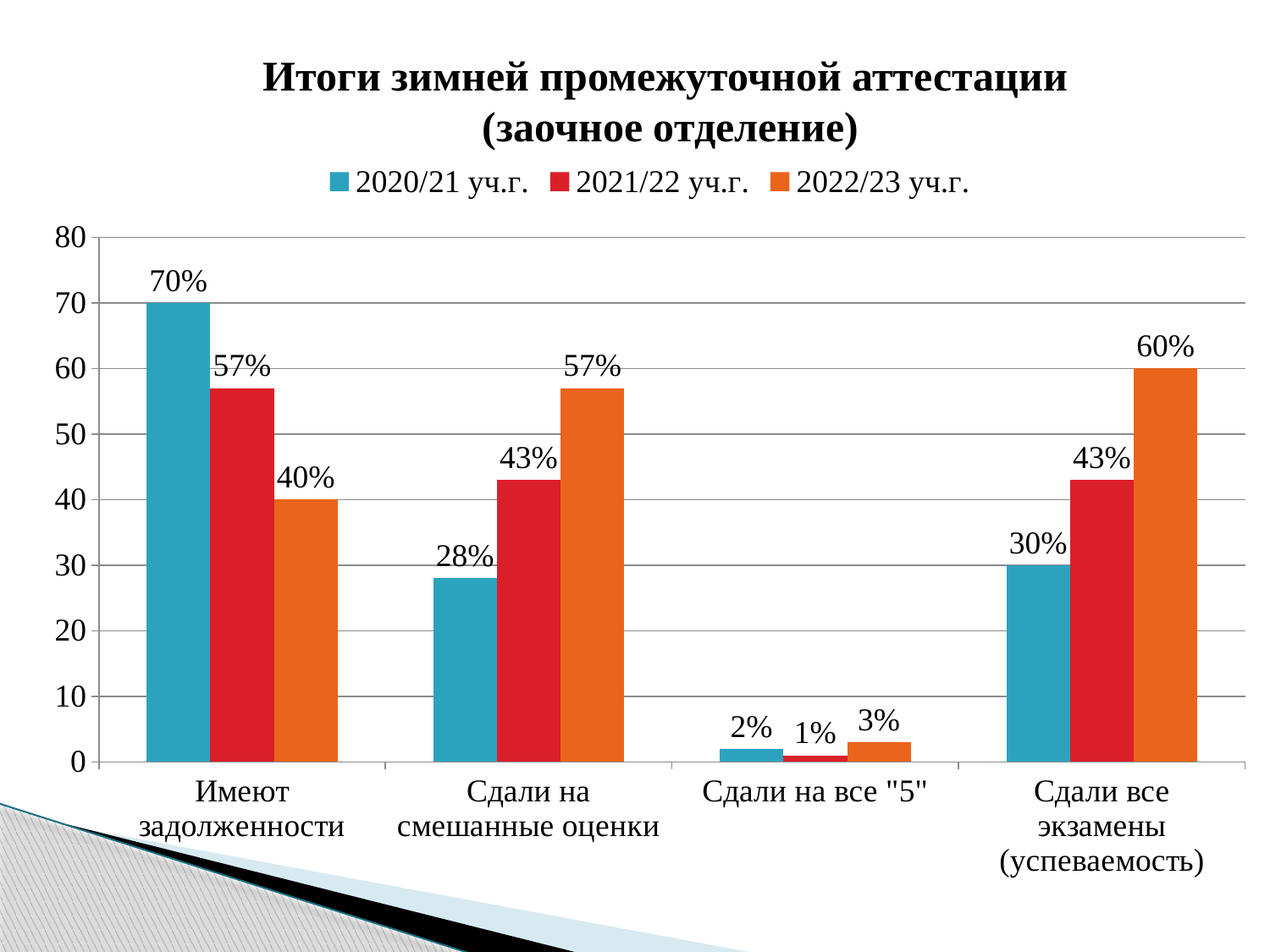
How many categories are shown on the x axis? 4 Which is larger in the "Сдали на смешанные оценки" category: the value for 2021/22 уч.г. or for 2022/23 уч.г.? 2022/23 уч.г. How many series does the legend list? 3 What is the difference between the 2020/21 уч.г. and 2022/23 уч.г. values in the "Имеют задолженности" category? 30% What is the value for 2022/23 уч.г. in the "Сдали все экзамены (успеваемость)" category? 60% Do the values for the "Имеют задолженности" category rise or fall from 2020/21 уч.г. to 2022/23 уч.г.? Fall What kind of chart is shown on the slide? Bar chart What is the value for 2021/22 уч.г. in the "Сдали на все "5"" category? 1% Which category has the highest value for 2022/23 уч.г.? Сдали все экзамены (успеваемость) What is the title of the chart? Итоги зимней промежуточной аттестации (заочное отделение) What is the value for 2020/21 уч.г. in the "Имеют задолженности" category? 70% Which category has the lowest value for 2020/21 уч.г.? Сдали на все "5"